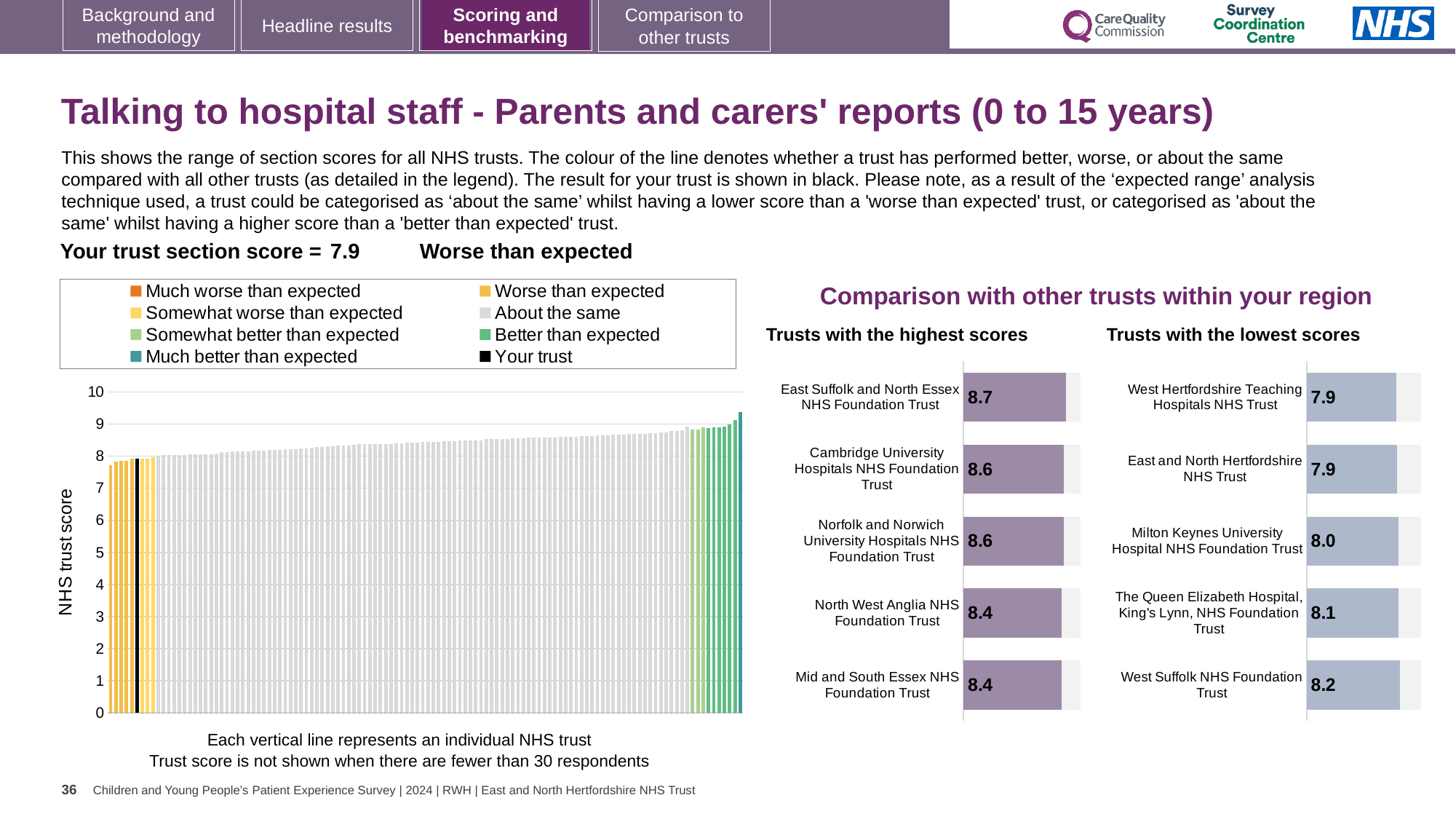
In the 'Trusts with the lowest scores' chart, what is the score for Milton Keynes University Hospital NHS Foundation Trust? 8.0 How many trusts are shown in the 'Trusts with the highest scores' chart? 5 In the 'Trusts with the lowest scores' chart, what is the score for West Suffolk NHS Foundation Trust? 8.2 In the 'Trusts with the lowest scores' chart, which has the larger score: Milton Keynes University Hospital NHS Foundation Trust or West Suffolk NHS Foundation Trust? West Suffolk NHS Foundation Trust In the 'Trusts with the highest scores' chart, what is the difference between the scores of East Suffolk and North Essex NHS Foundation Trust and Mid and South Essex NHS Foundation Trust? 0.3 In the 'Trusts with the highest scores' chart, which trust has the highest score? East Suffolk and North Essex NHS Foundation Trust In the 'Trusts with the highest scores' chart, what is the score for North West Anglia NHS Foundation Trust? 8.4 In the 'Trusts with the lowest scores' chart, which trust has the highest score shown? West Suffolk NHS Foundation Trust How many entries does the legend of the large chart on the left list? 8 In the 'Trusts with the highest scores' chart, what is the score for East Suffolk and North Essex NHS Foundation Trust? 8.7 In the large chart on the left, do the trust scores rise or fall from left to right? Rise What kind of chart is the large chart on the left showing NHS trust scores? Bar chart